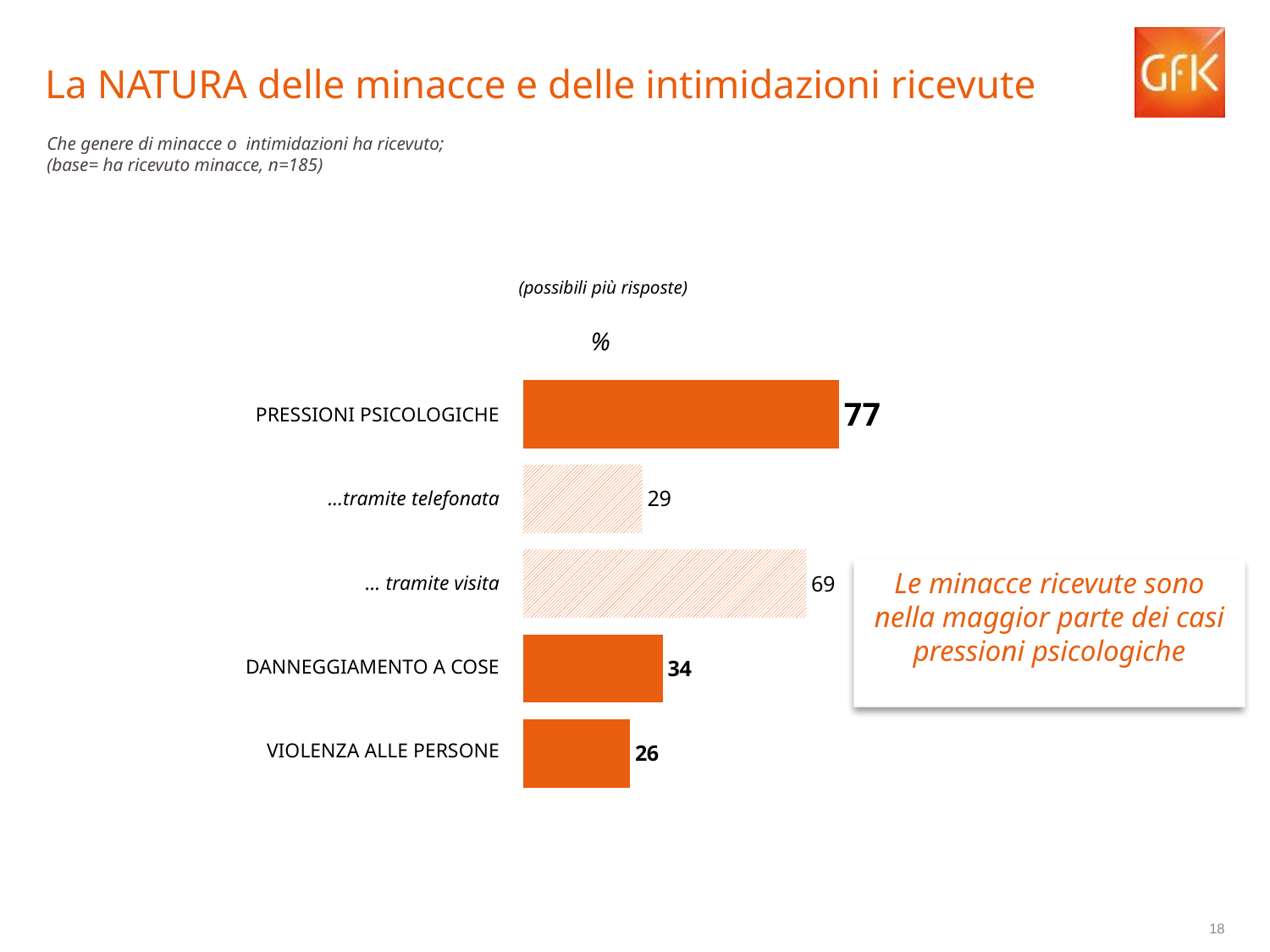
What is the value for DANNEGGIAMENTO A COSE? 34 Which category has the highest value? PRESSIONI PSICOLOGICHE What is the difference between the values for PRESSIONI PSICOLOGICHE and DANNEGGIAMENTO A COSE? 43 What is the difference between the values for ... tramite visita and ...tramite telefonata? 40 What is the value for ...tramite telefonata? 29 What kind of chart is shown on the slide? Bar chart What is the value for PRESSIONI PSICOLOGICHE? 77 What is the value for ... tramite visita? 69 What is the value for VIOLENZA ALLE PERSONE? 26 Which category has the lowest value? VIOLENZA ALLE PERSONE Which is larger, the value for DANNEGGIAMENTO A COSE or the value for VIOLENZA ALLE PERSONE? DANNEGGIAMENTO A COSE How many bars are shown in the chart? 5